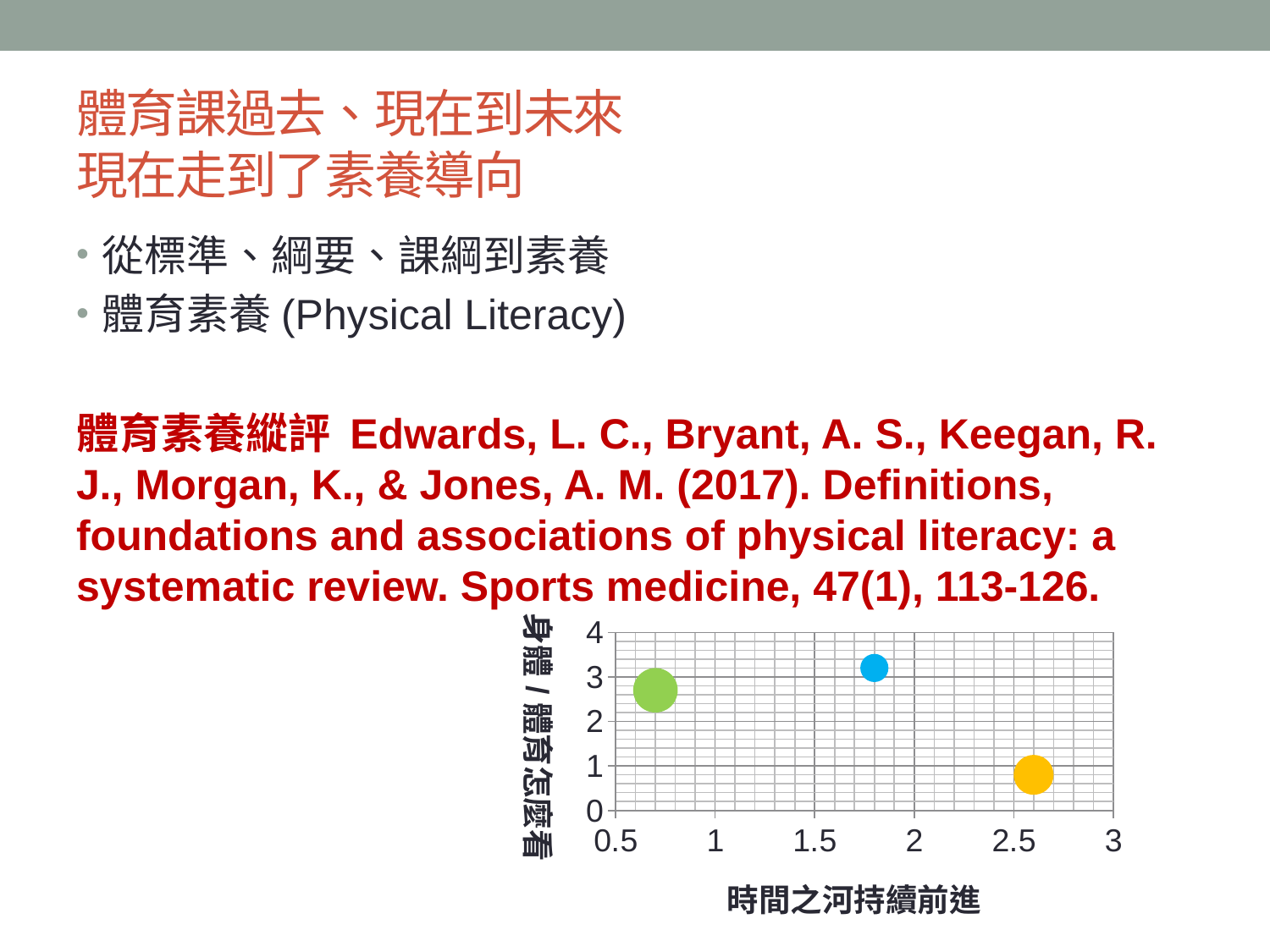
What kind of chart is shown at the bottom of the slide? bubble chart Is the horizontal-axis value of the green bubble greater or less than 1? less Which bubble is furthest to the left along the horizontal axis? the green bubble What is the title of the horizontal axis of the chart? 時間之河持續前進 Is the vertical-axis value of the blue bubble greater or less than 2? greater Is the vertical-axis value of the yellow bubble greater or less than 2? less Which bubble has a larger vertical-axis value, the green bubble or the yellow bubble? the green bubble How many bubbles are plotted on the chart? 3 What is the title of the vertical axis of the chart? 身體／體育怎麼看 Which bubble has the highest vertical-axis value? the blue bubble Which bubble has the lowest vertical-axis value? the yellow bubble Which bubble is furthest to the right along the horizontal axis? the yellow bubble